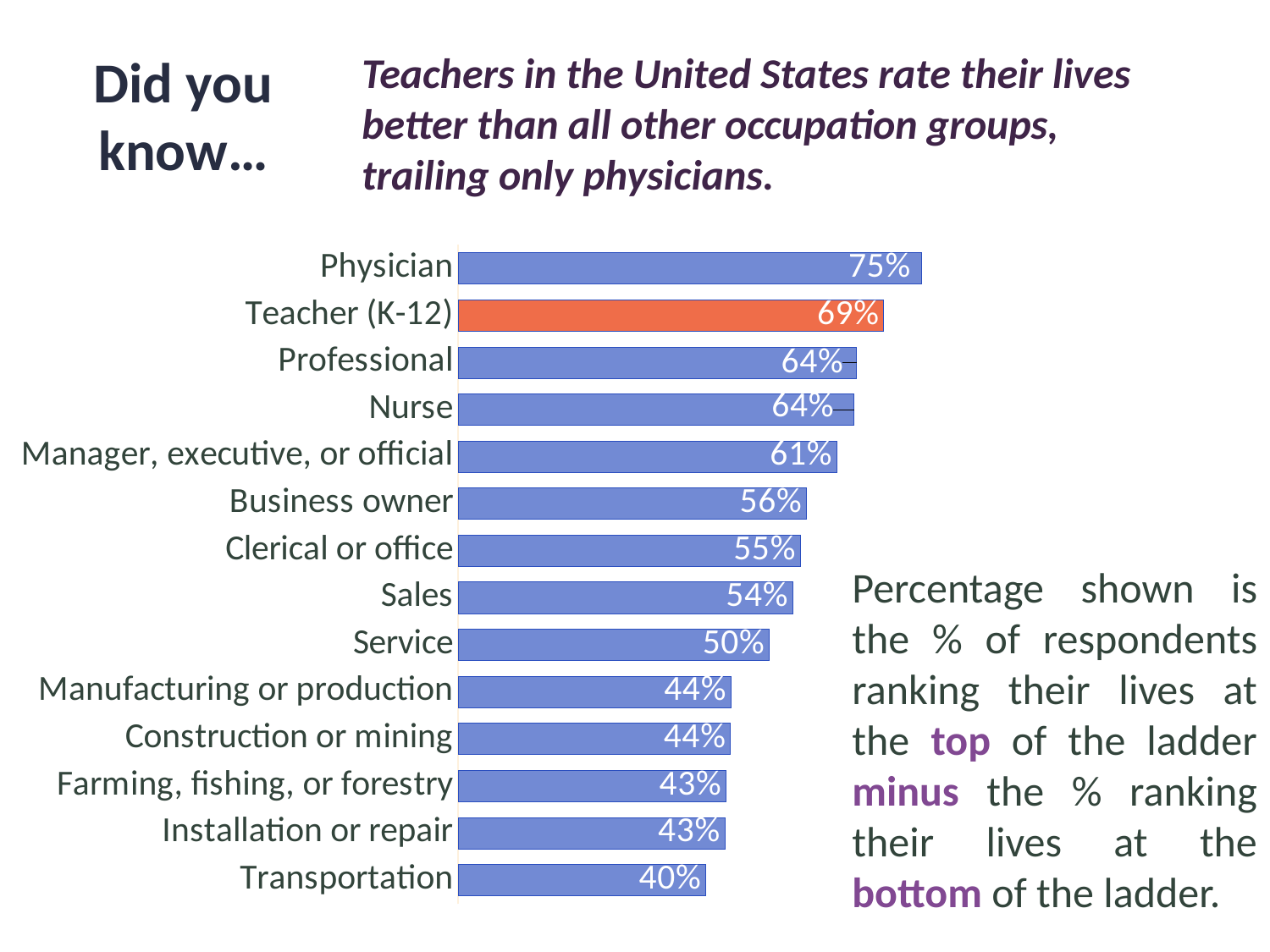
Which occupation group has the highest value? Physician What is the value for Teacher (K-12)? 69% Which bar is coloured differently (orange) from the others? Teacher (K-12) What is the value for Physician? 75% Which is larger, the value for Business owner or the value for Service? Business owner What kind of chart is shown on the slide? Bar chart What is the value for Manager, executive, or official? 61% Which occupation group has the lowest value? Transportation How many occupation groups are shown in the chart? 14 What is the value for Transportation? 40% What is the difference between the values for Physician and Teacher (K-12)? 6% What is the value for Clerical or office? 55%